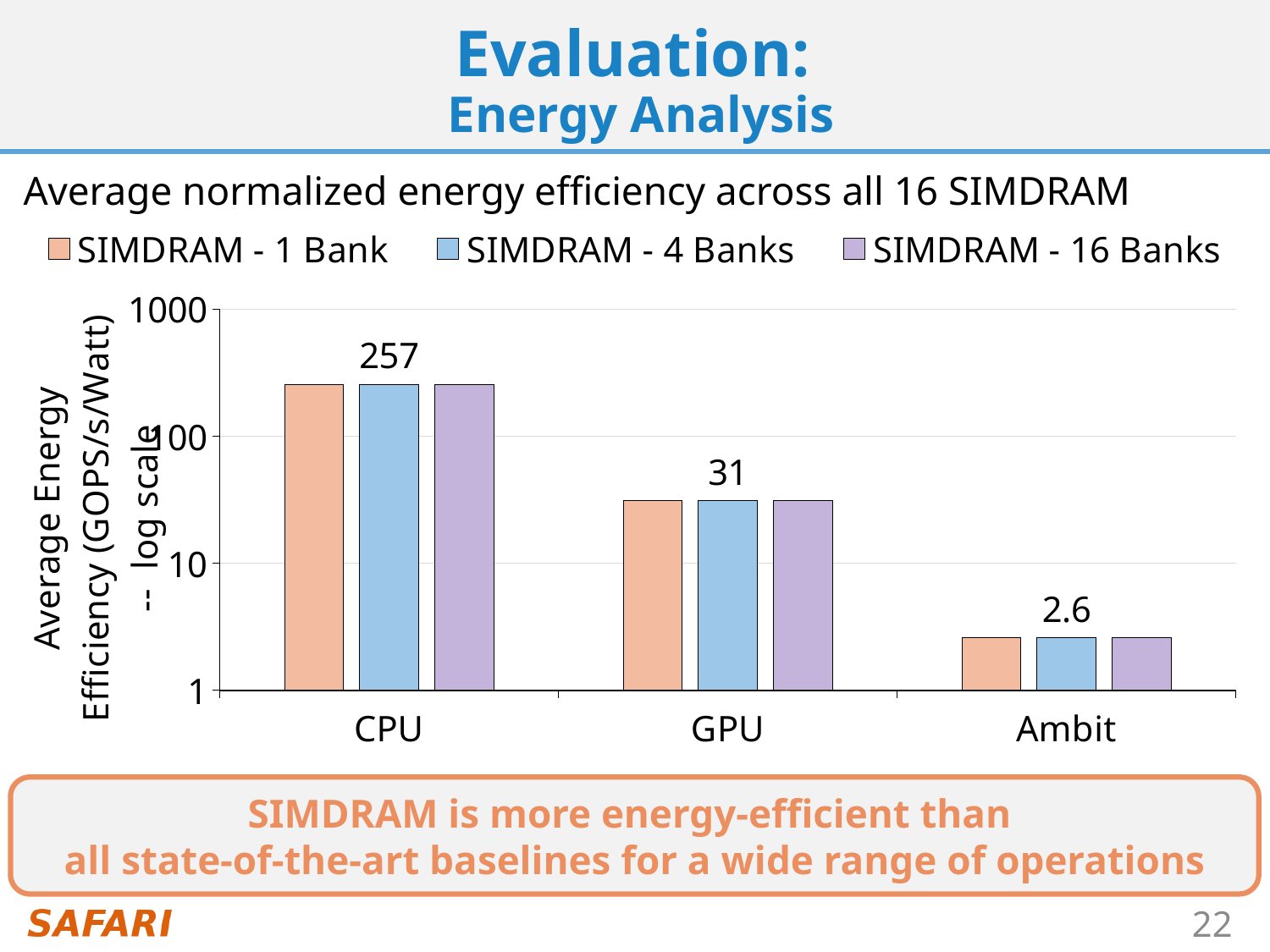
How many categories are shown on the x axis? 3 What kind of chart is shown on the slide? bar chart Which category has the lowest labeled energy efficiency value? Ambit Do the labeled values rise or fall moving from CPU to GPU to Ambit along the x axis? fall What value is labeled above the GPU group of bars? 31 Is the value for the SIMDRAM - 16 Banks bar at CPU greater or less than 100? greater What is the difference between the labeled values for CPU and GPU? 226 Which category has the highest labeled energy efficiency value? CPU Is the value for the SIMDRAM - 1 Bank bar at Ambit greater or less than 10? less How many series does the legend list? 3 What value is labeled above the CPU group of bars? 257 What value is labeled above the Ambit group of bars? 2.6